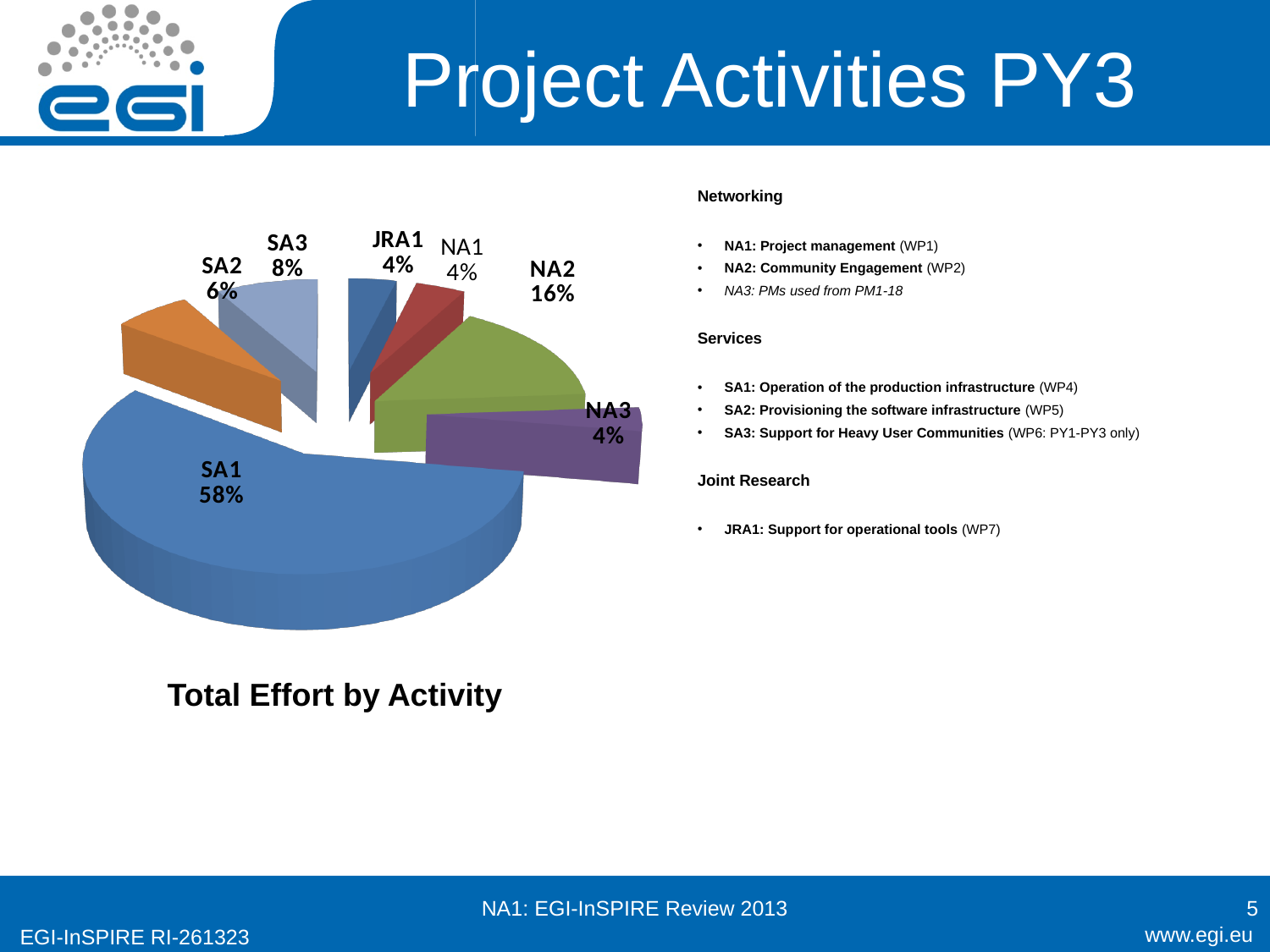
What is the title of the pie chart? Total Effort by Activity What is the combined share of NA1, NA3 and JRA1? 12% What percentage of total effort is shown for NA2? 16% What percentage of total effort is shown for SA3? 8% What share of total effort does SA1 account for in the pie chart? 58% How many activities are shown as slices in the pie chart? 7 What kind of chart is used to show total effort by activity? Pie chart Which activity has the largest share of total effort? SA1 What percentage of total effort is shown for SA2? 6% Which activity has the second largest share of total effort? NA2 What is the difference in percentage points between the shares of SA1 and NA2? 42 Which has a larger share of total effort, SA3 or SA2? SA3